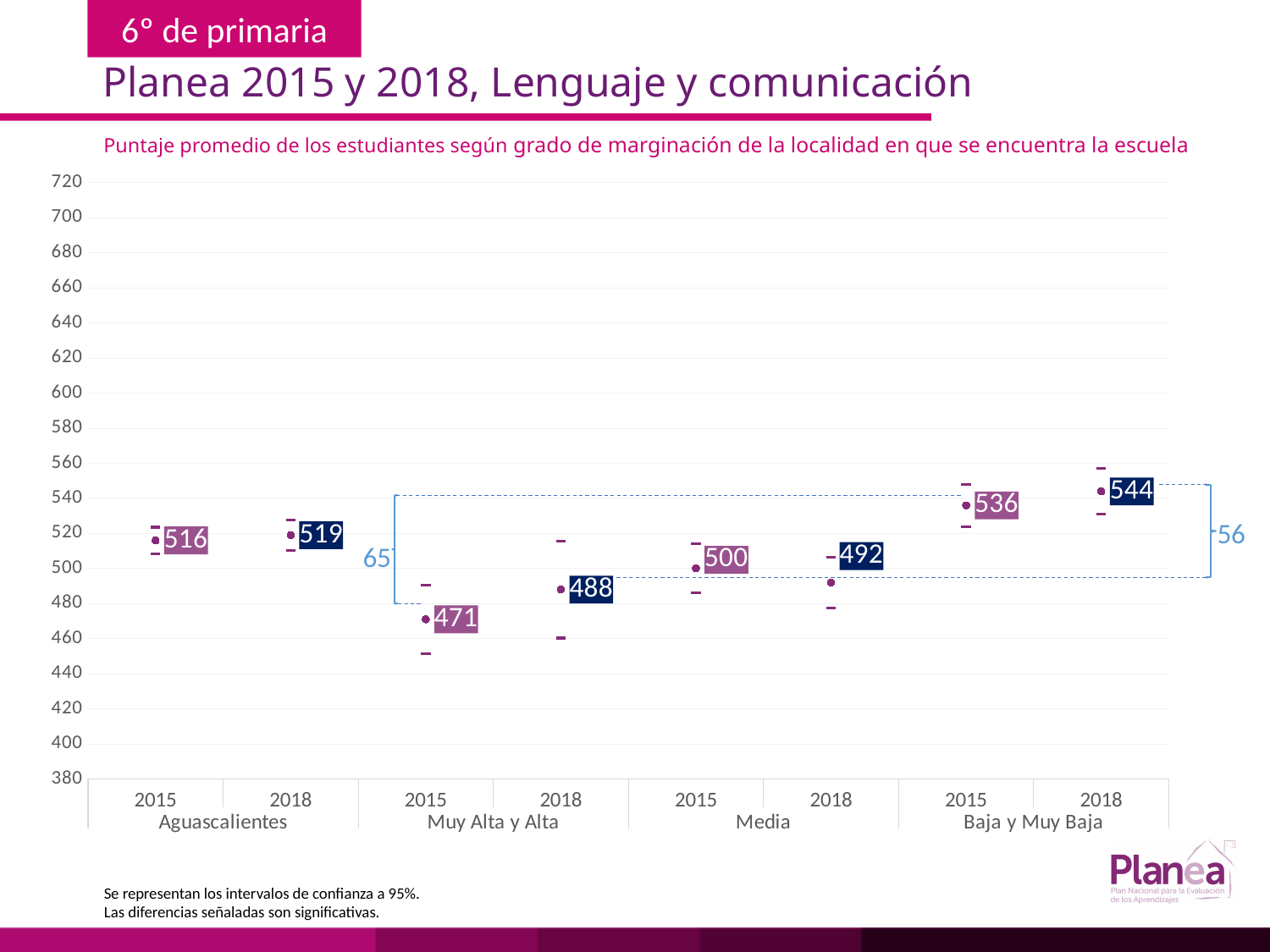
Which group and year has the lowest average score? Muy Alta y Alta, 2015 Which is larger, the Media score in 2015 or in 2018? 2015 How many data points are plotted on the chart? 8 What is the average score for Baja y Muy Baja marginación in 2018? 544 What does the note below the chart say the bars around each point represent? Intervalos de confianza a 95% Is the 2015 score for Muy Alta y Alta marginación greater or less than 480? less What is the average score for Aguascalientes in 2015? 516 What is the average score for Media marginación in 2015? 500 What is the difference between the 2018 and 2015 scores for Muy Alta y Alta marginación? 17 What is the difference between the 2015 scores of Baja y Muy Baja and Muy Alta y Alta marginación? 65 Which group and year has the highest average score? Baja y Muy Baja, 2018 What is the average score for Muy Alta y Alta marginación in 2018? 488